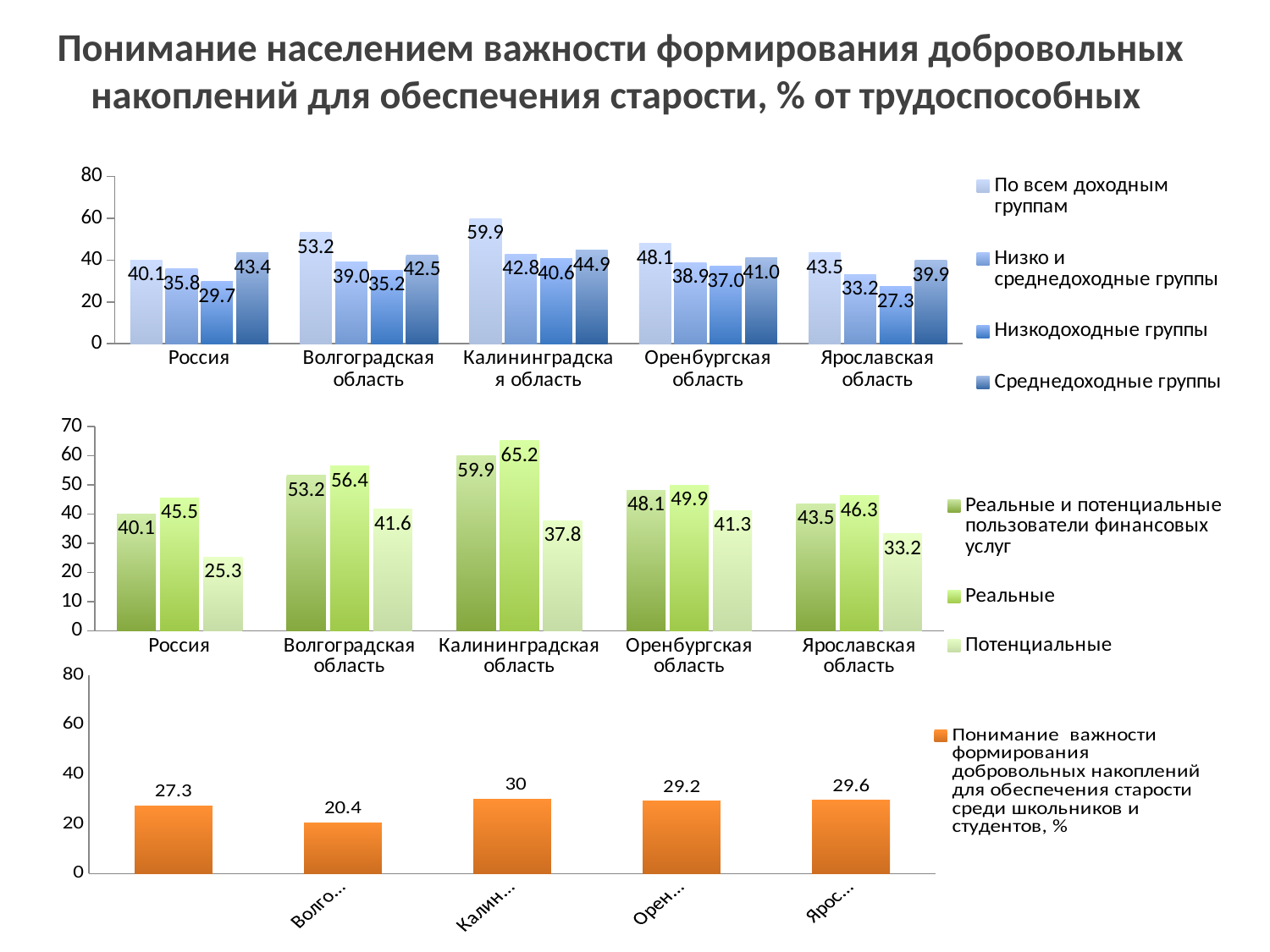
In the top chart, which category has the lowest value in the series 'Низко и среднедоходные группы'? Ярославская область What kind of chart is the bottom chart? Bar chart In the top chart, what is the value for Ярославская область in the series 'Низкодоходные группы'? 27.3 In the bottom chart, what is the highest value shown? 30 In the middle chart, which category has the lowest value in the series 'Потенциальные'? Россия In the top chart, what is the difference between the 'Среднедоходные группы' and 'Низкодоходные группы' values for Россия? 13.7 In the bottom chart, what is the lowest value shown? 20.4 In the middle chart, what is the value for Калининградская область in the series 'Реальные'? 65.2 In the middle chart, which is larger for Оренбургская область: 'Реальные' or 'Потенциальные'? Реальные In the middle chart, how many categories are shown on the x axis? 5 In the top chart, how many series does the legend list? 4 In the top chart, what is the value for Калининградская область in the series 'По всем доходным группам'? 59.9